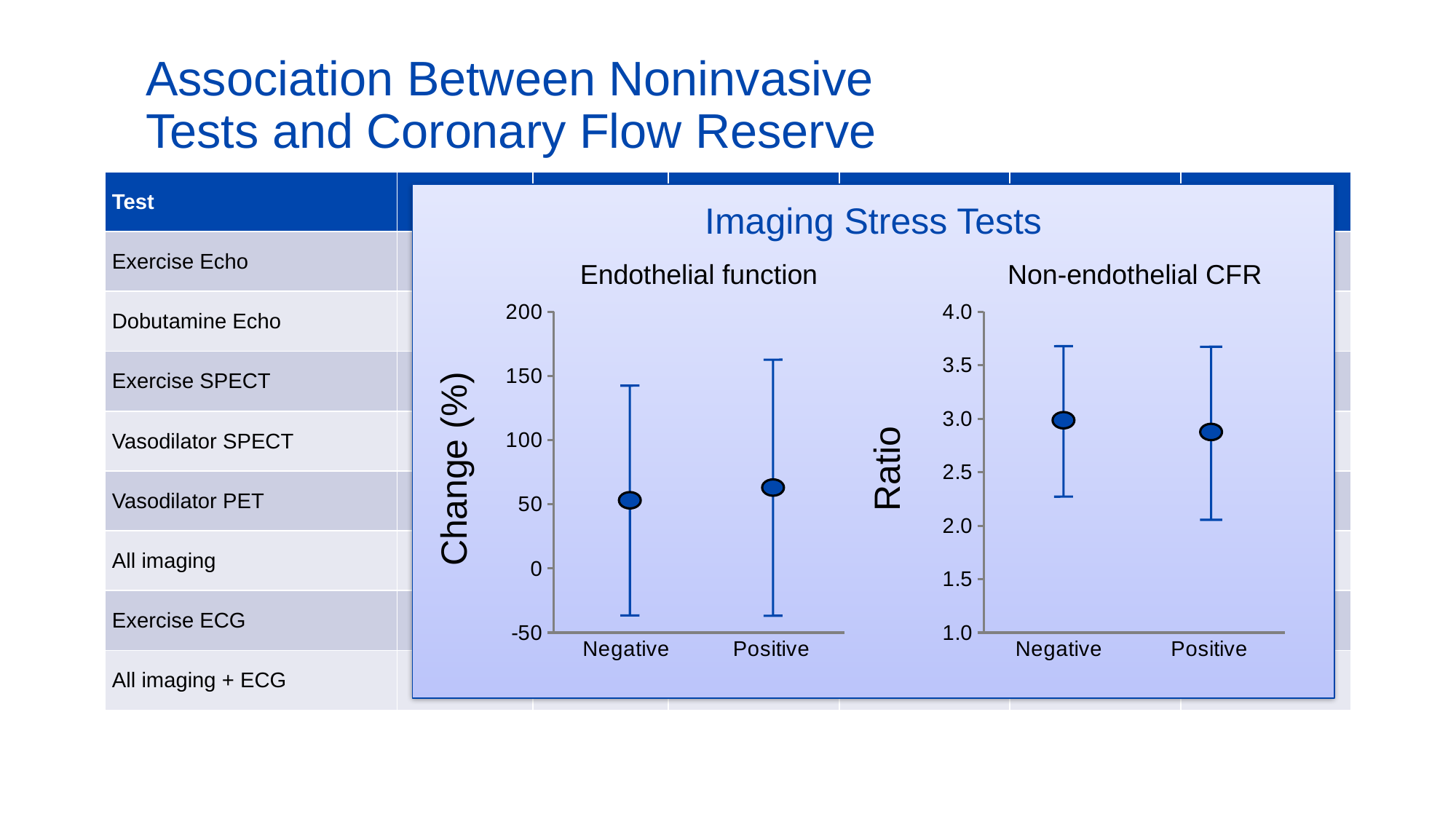
In the Endothelial function chart, is the value for Positive greater or less than 50? greater In the Endothelial function chart, is the value for Negative greater or less than 0? greater In the Non-endothelial CFR chart, is the value for Positive greater or less than 2.5? greater In the Non-endothelial CFR chart, how many categories are shown on the x axis? 2 What is the y-axis label of the Non-endothelial CFR chart? Ratio What is the y-axis label of the Endothelial function chart? Change (%) What kind of chart is the Endothelial function chart? scatter chart with error bars In the Endothelial function chart, how many categories are shown on the x axis? 2